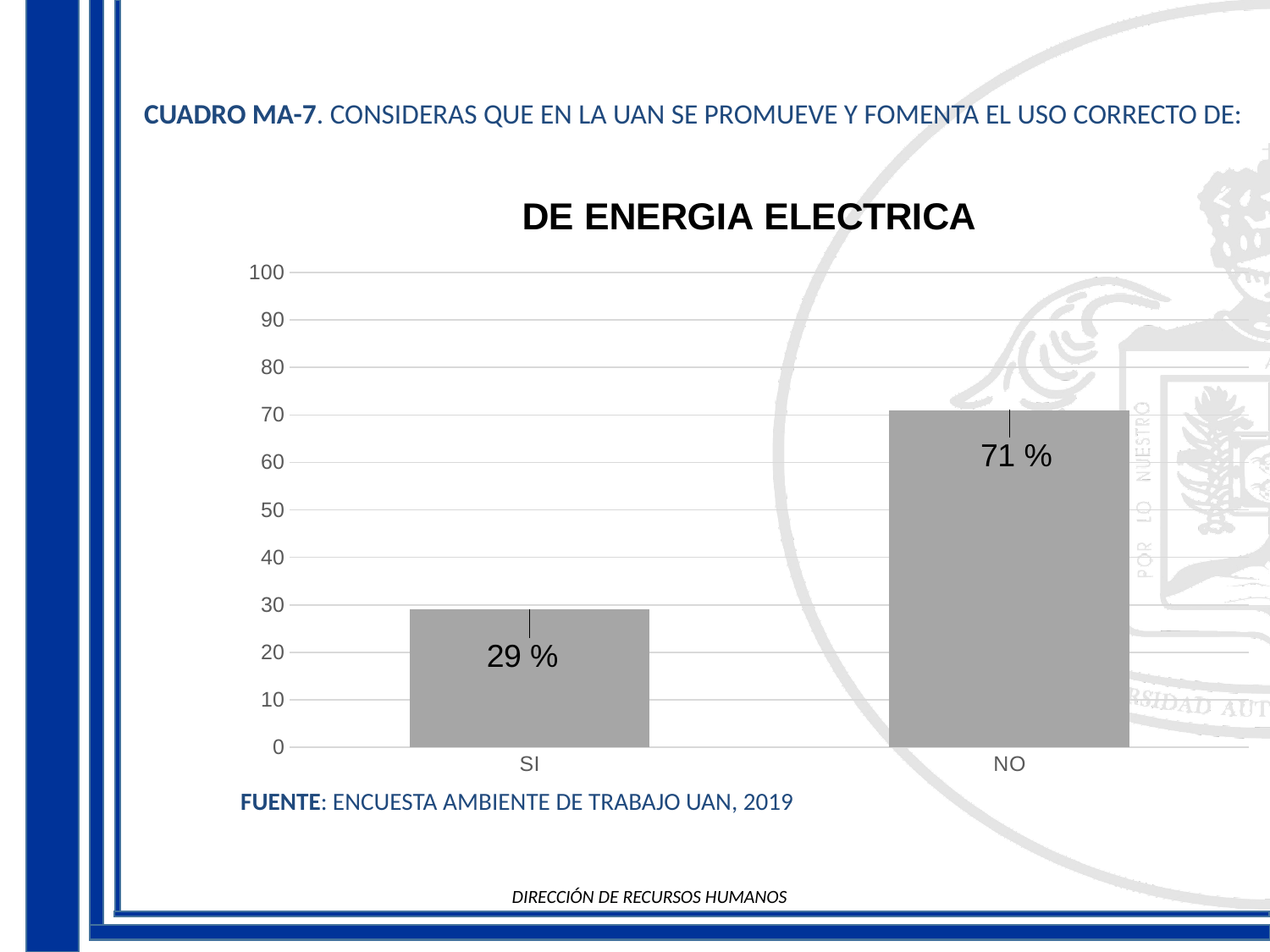
Is the value for SI greater or less than 40? less What kind of chart is shown? bar chart What is the value for NO? 71 % How many categories are shown on the x axis? 2 What is the value for SI? 29 % Which category has the lowest value? SI What is the title of the chart? DE ENERGIA ELECTRICA What is the highest value shown on the y axis? 100 Which category has the highest value? NO Is the value for NO greater or less than 60? greater What is the difference between the values for NO and SI? 42 % Which is larger, the value for SI or the value for NO? NO